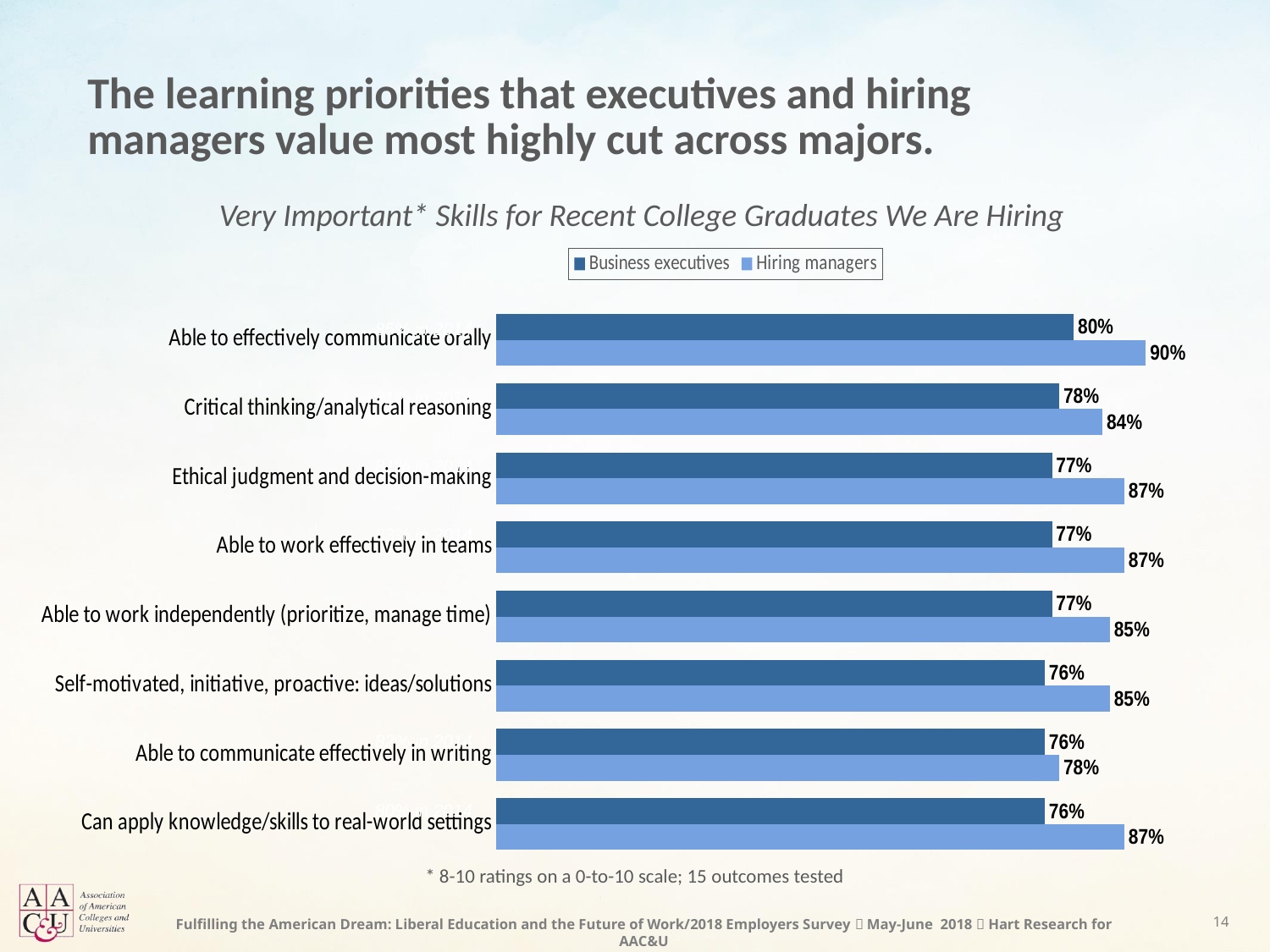
What is the subtitle of the chart? Very Important* Skills for Recent College Graduates We Are Hiring For 'Can apply knowledge/skills to real-world settings', which series has the larger value, Business executives or Hiring managers? Hiring managers How many series does the legend list? 2 What percentage of business executives rated 'Critical thinking/analytical reasoning' as very important? 78% Which skill has the lowest Hiring managers value? Able to communicate effectively in writing Which skill has the highest Hiring managers value? Able to effectively communicate orally What kind of chart is shown on the slide? Bar chart How many skill categories are plotted in the chart? 8 What is the Hiring managers value for 'Able to communicate effectively in writing'? 78% Which skill has the highest Business executives value? Able to effectively communicate orally What percentage of hiring managers rated 'Able to effectively communicate orally' as very important? 90% What is the difference between the Hiring managers and Business executives values for 'Ethical judgment and decision-making'? 10 percentage points